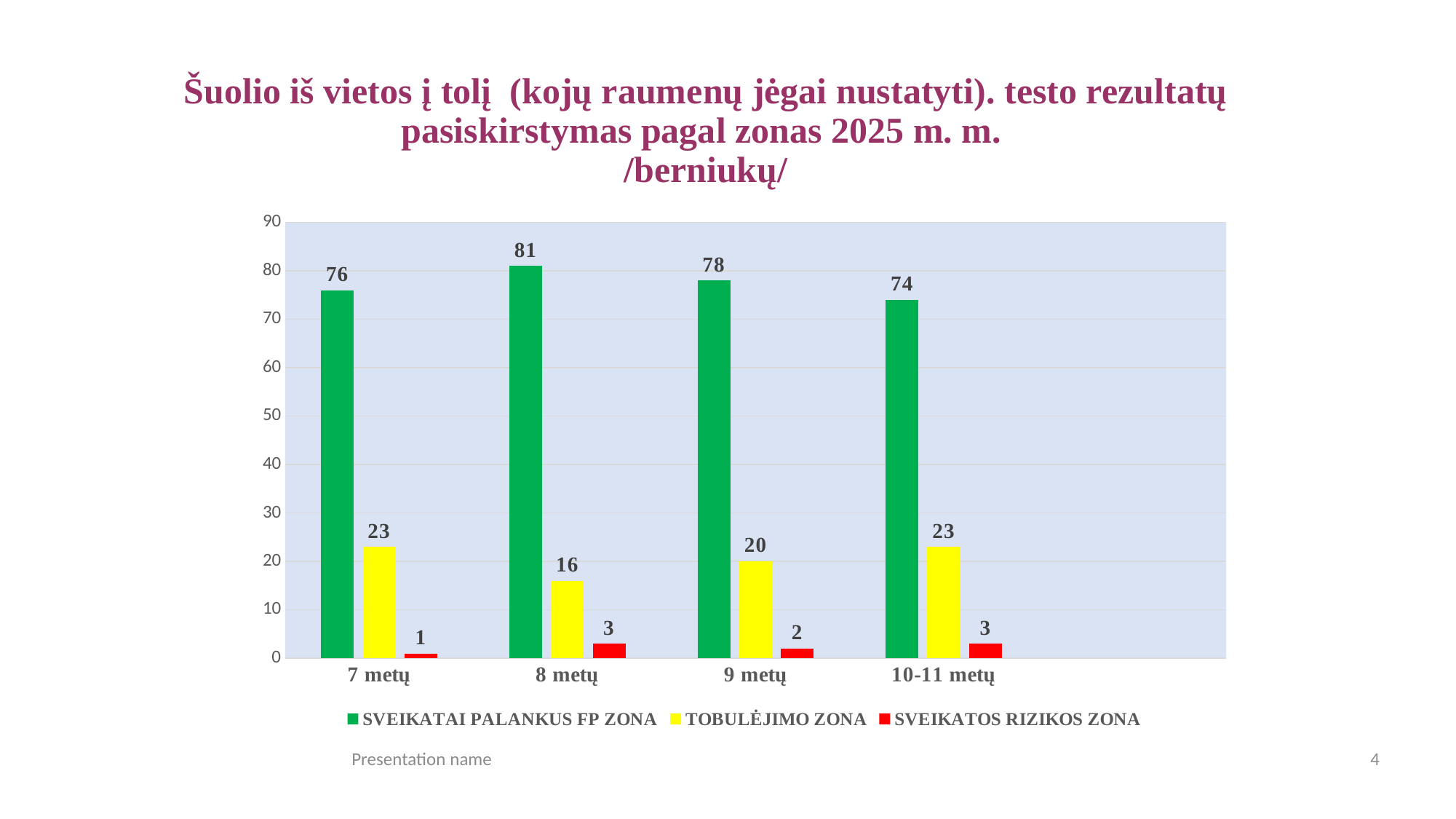
Which age group has the highest value for SVEIKATAI PALANKUS FP ZONA? 8 metų What kind of chart is shown on the slide? bar chart What is the value for SVEIKATOS RIZIKOS ZONA for 7 metų? 1 What is the value for SVEIKATAI PALANKUS FP ZONA for 8 metų? 81 What is the difference between the SVEIKATAI PALANKUS FP ZONA values for 8 metų and 10-11 metų? 7 How many series does the legend list? 3 Which is larger: the TOBULĖJIMO ZONA value for 7 metų or for 9 metų? 7 metų Which age group has the lowest value for TOBULĖJIMO ZONA? 8 metų How many age groups are shown on the x axis? 4 What is the value for TOBULĖJIMO ZONA for 9 metų? 20 What colour are the bars for SVEIKATOS RIZIKOS ZONA? red Is the value for SVEIKATAI PALANKUS FP ZONA for 10-11 metų greater or less than 70? greater